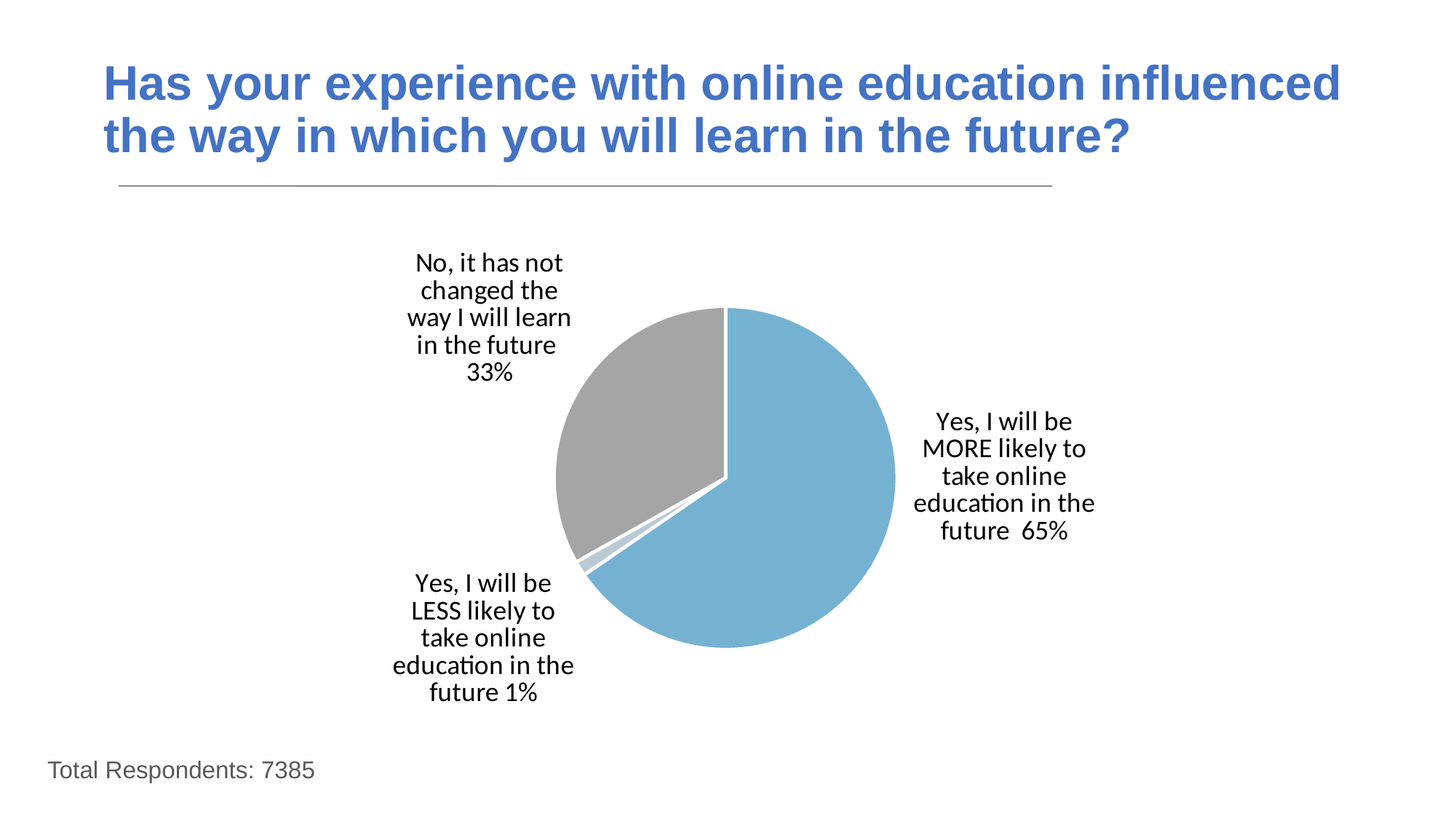
What percentage of respondents said they will be LESS likely to take online education in the future? 1% What is the total number of respondents stated on the slide? 7385 What kind of chart is shown on the slide? pie chart Which response has the largest share of the pie? Yes, I will be MORE likely to take online education in the future What percentage of respondents said their experience has not changed the way they will learn in the future? 33% What colour is the slice for 'No, it has not changed the way I will learn in the future'? grey What percentage of respondents said they will be MORE likely to take online education in the future? 65% Which response has the smallest share of the pie? Yes, I will be LESS likely to take online education in the future What is the difference in percentage points between the 'MORE likely' and 'not changed' responses? 32 Which is larger: the share for 'No, it has not changed the way I will learn in the future' or the share for 'Yes, I will be LESS likely to take online education in the future'? No, it has not changed the way I will learn in the future How many slices does the pie chart have? 3